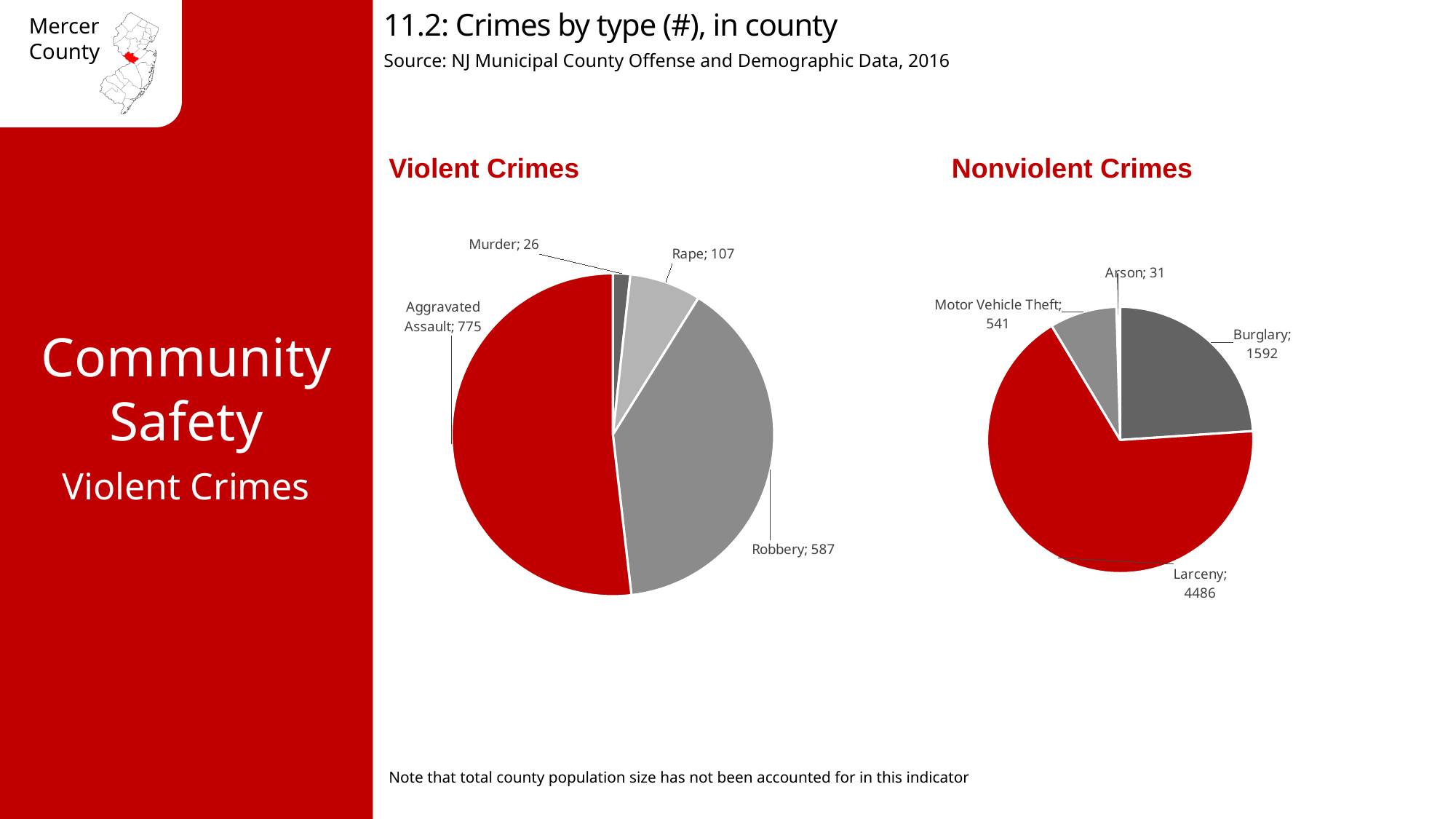
In the Nonviolent Crimes chart, what is the value for Burglary? 1592 In the Violent Crimes chart, what is the total number of violent crimes across all slices? 1495 In the Nonviolent Crimes chart, which crime type has the largest value? Larceny In the Violent Crimes chart, what is the difference between Aggravated Assault and Robbery? 188 In the Violent Crimes chart, which crime type has the smallest slice? Murder What type of chart is used for Violent Crimes? Pie chart How many crime types are shown in the Nonviolent Crimes chart? 4 In the Violent Crimes chart, how many robberies are shown? 587 In the Nonviolent Crimes chart, what is the difference between Burglary and Motor Vehicle Theft? 1051 In the Violent Crimes chart, which is larger, Rape or Murder? Rape In the Violent Crimes chart, which crime type has the largest slice? Aggravated Assault In the Nonviolent Crimes chart, which crime type has the smallest value? Arson